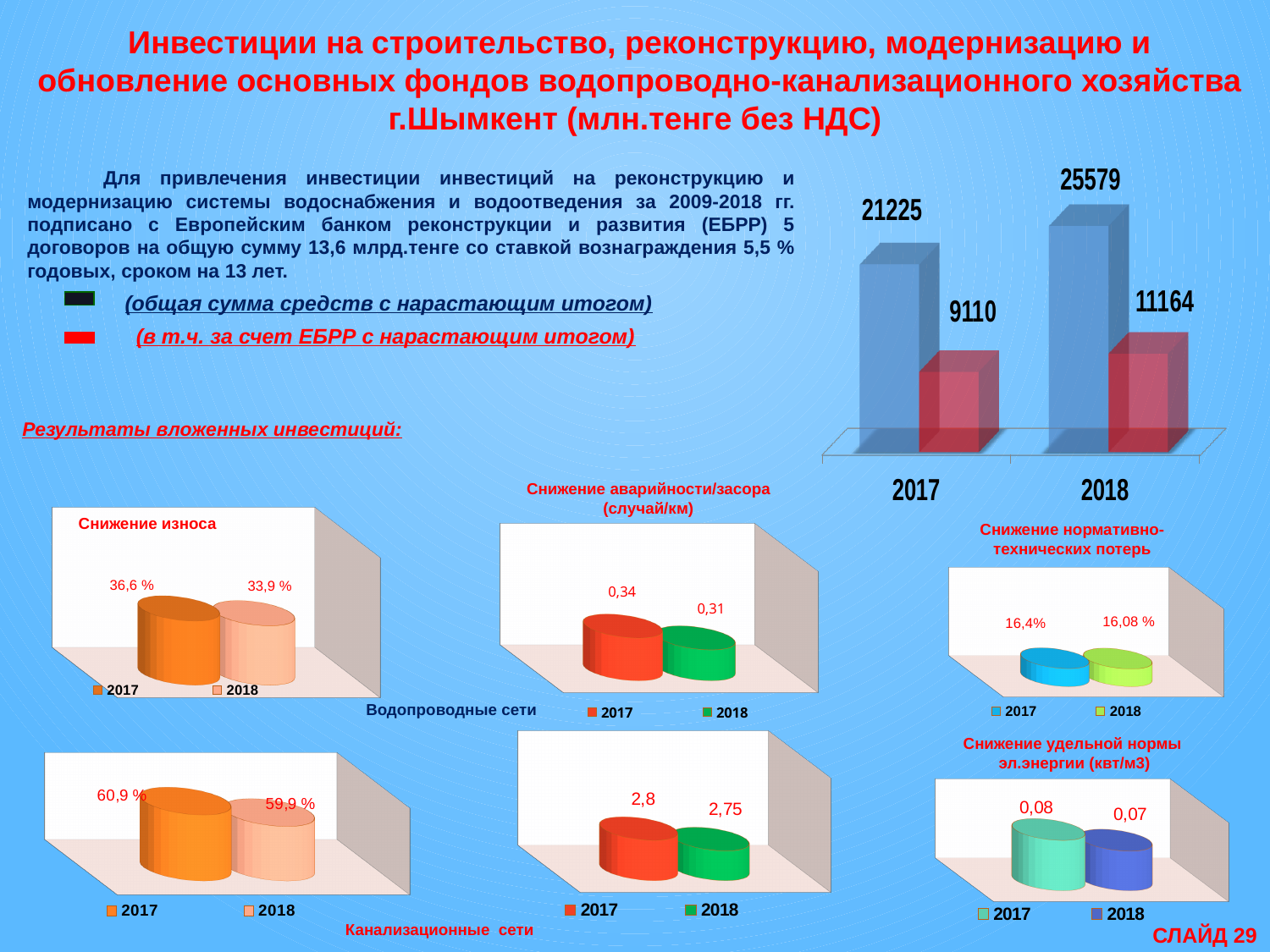
In the large bar chart at the top right of the slide, what is the difference between the blue bar values for 2018 and 2017? 4354 In the 'Снижение износа' chart for Канализационные сети, what is the value for 2017? 60,9 % In the 'Снижение аварийности/засора (случай/км)' chart for Канализационные сети, which year has the higher value? 2017 In the 'Снижение износа' chart for Водопроводные сети, what is the value for 2018? 33,9 % In the 'Снижение аварийности/засора (случай/км)' chart for Водопроводные сети, what is the value for 2018? 0,31 What type of chart is the large chart at the top right of the slide? bar chart In the large bar chart at the top right of the slide, what is the value of the shorter (red) bar for 2017? 9110 In the large bar chart at the top right of the slide, how many years are shown on the x axis? 2 In the 'Снижение удельной нормы эл.энергии (квт/м3)' chart, what is the value for 2018? 0,07 In the 'Снижение нормативно-технических потерь' chart, what is the value for 2017? 16,4% In the large bar chart at the top right of the slide, which year has the higher red bar value? 2018 In the large bar chart at the top right of the slide, what is the value of the taller (blue) bar for 2018? 25579